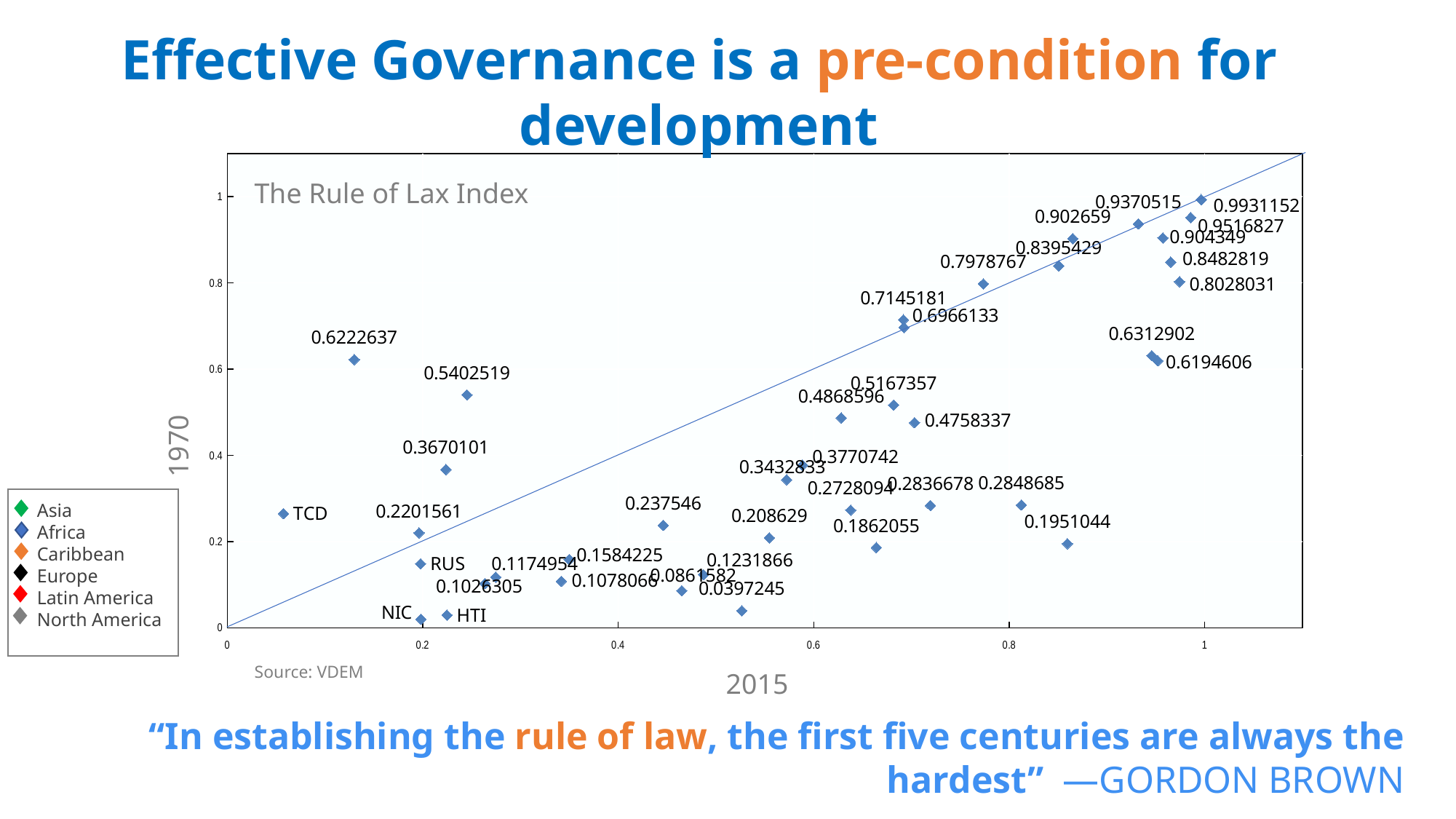
What is the title printed inside the chart area? The Rule of Lax Index What is the highest data-label value printed on the chart? 0.9931152 What kind of chart is shown on the slide? scatter chart Is the 1970 value (vertical axis) for TCD greater or less than 0.2? greater What is the lowest data-label value printed on the chart? 0.0397245 Is the 1970 value (vertical axis) for RUS greater or less than 0.4? less How many points on the chart are labelled with a country code rather than a number? 4 Is the 1970 value (vertical axis) for HTI greater or less than 0.2? less What source is cited below the chart? VDEM How many regions does the chart's legend list? 6 Which has the higher 1970 value (vertical axis), TCD or HTI? TCD